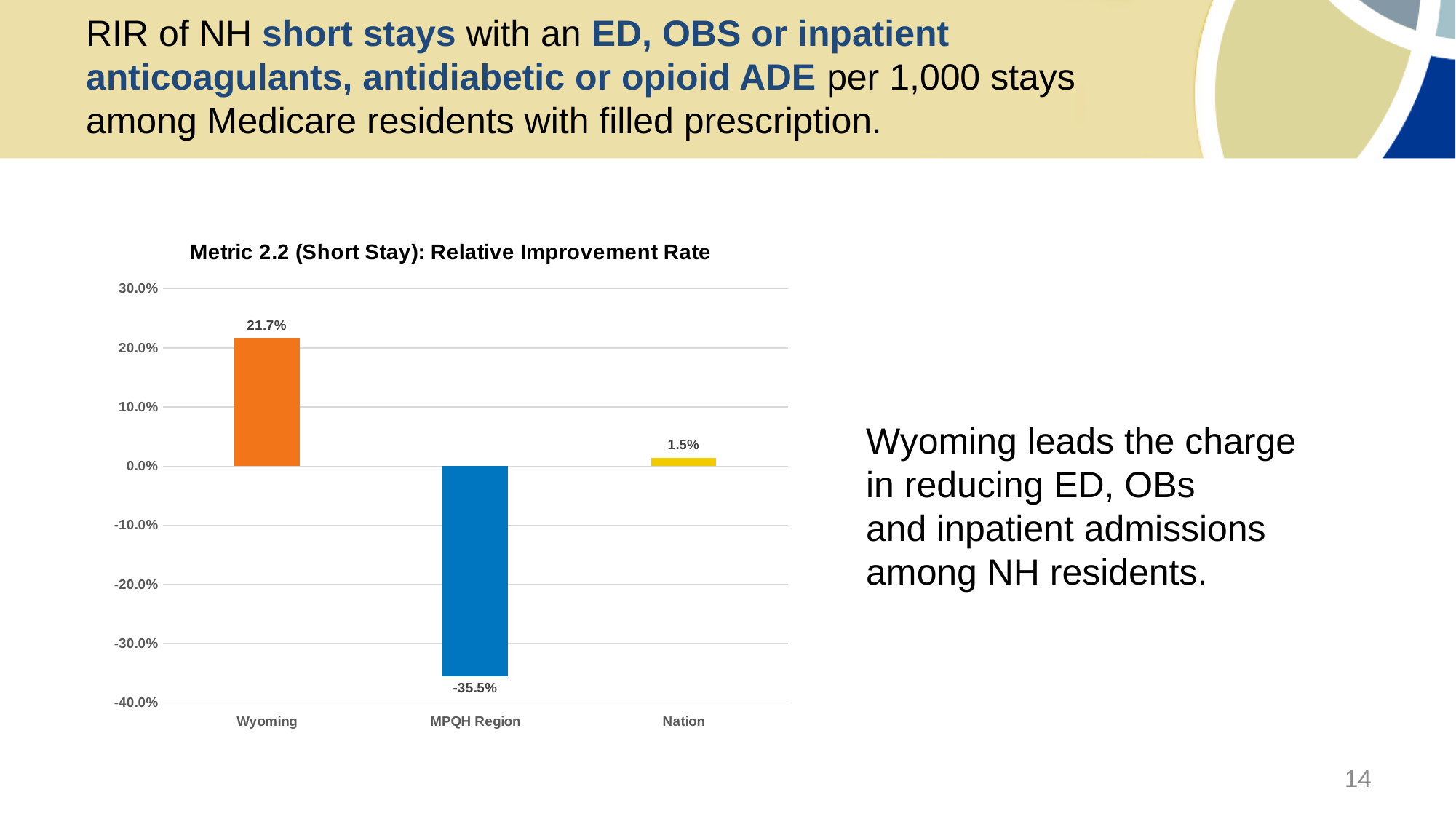
What is the title of the chart? Metric 2.2 (Short Stay): Relative Improvement Rate Which category has the lowest relative improvement rate? MPQH Region How many categories are shown on the x axis of the chart? 3 Is the value for Wyoming greater or less than 20.0%? greater What is the relative improvement rate for the Nation? 1.5% Which has a larger relative improvement rate, the Nation or the MPQH Region? Nation What is the difference between the relative improvement rates of Wyoming and the MPQH Region? 57.2% What is the relative improvement rate for Wyoming? 21.7% Which category has the highest relative improvement rate? Wyoming What is the difference between the relative improvement rates of Wyoming and the Nation? 20.2% What kind of chart is shown on the slide? Bar chart What is the relative improvement rate for the MPQH Region? -35.5%